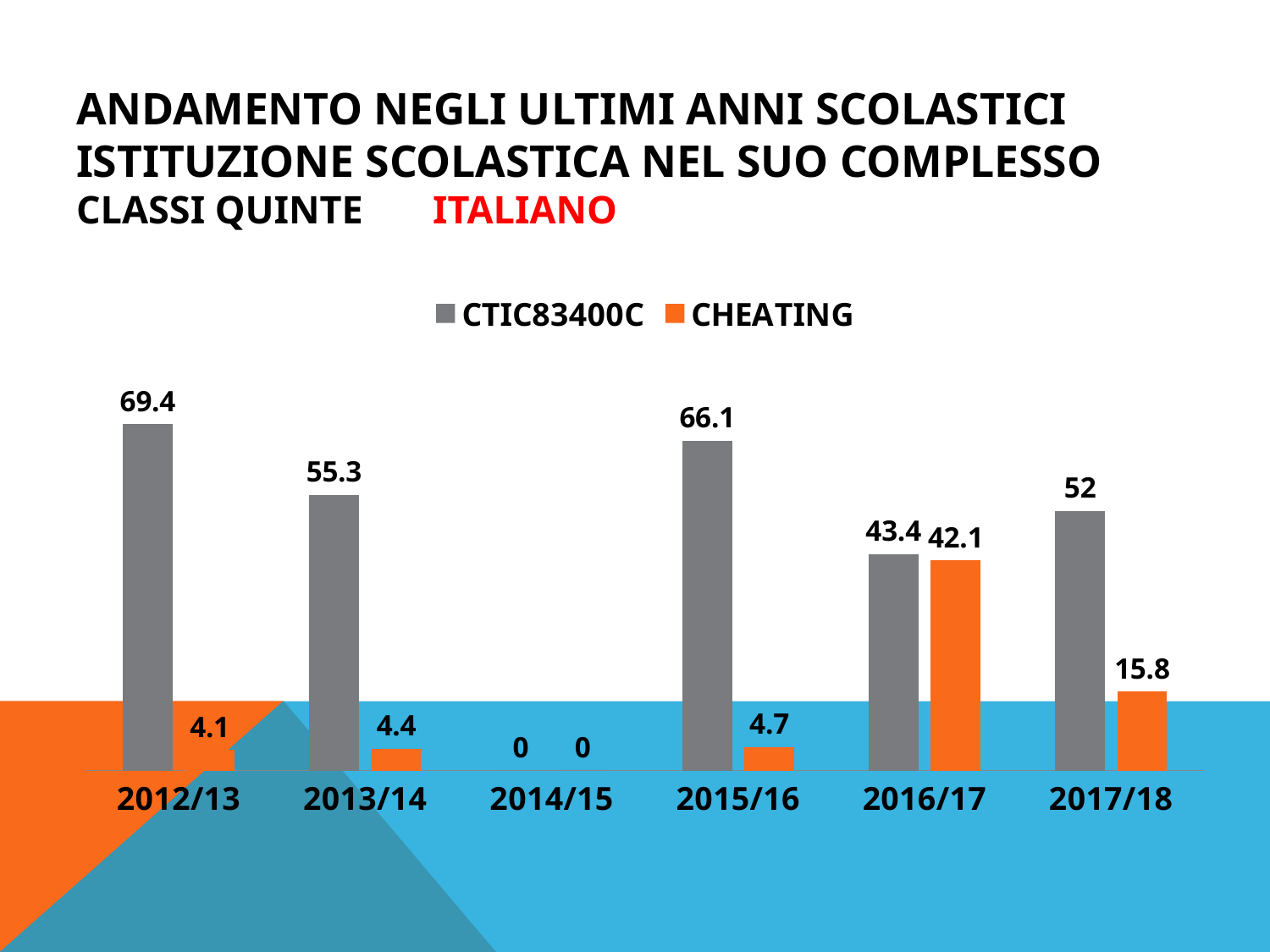
Which school year has the lowest CHEATING value? 2014/15 Which school year has the highest CTIC83400C value? 2012/13 What is the CTIC83400C value for 2012/13? 69.4 How many series does the legend list? 2 What is the CHEATING value for 2017/18? 15.8 What kind of chart is shown on the slide? bar chart What is the difference between the CTIC83400C and CHEATING values for 2016/17? 1.3 What is the CHEATING value for 2016/17? 42.1 Which colour represents the CHEATING series? orange What is the difference between the CTIC83400C values for 2015/16 and 2017/18? 14.1 How many school years are shown on the x axis? 6 Which is larger, the CTIC83400C value for 2013/14 or for 2015/16? 2015/16